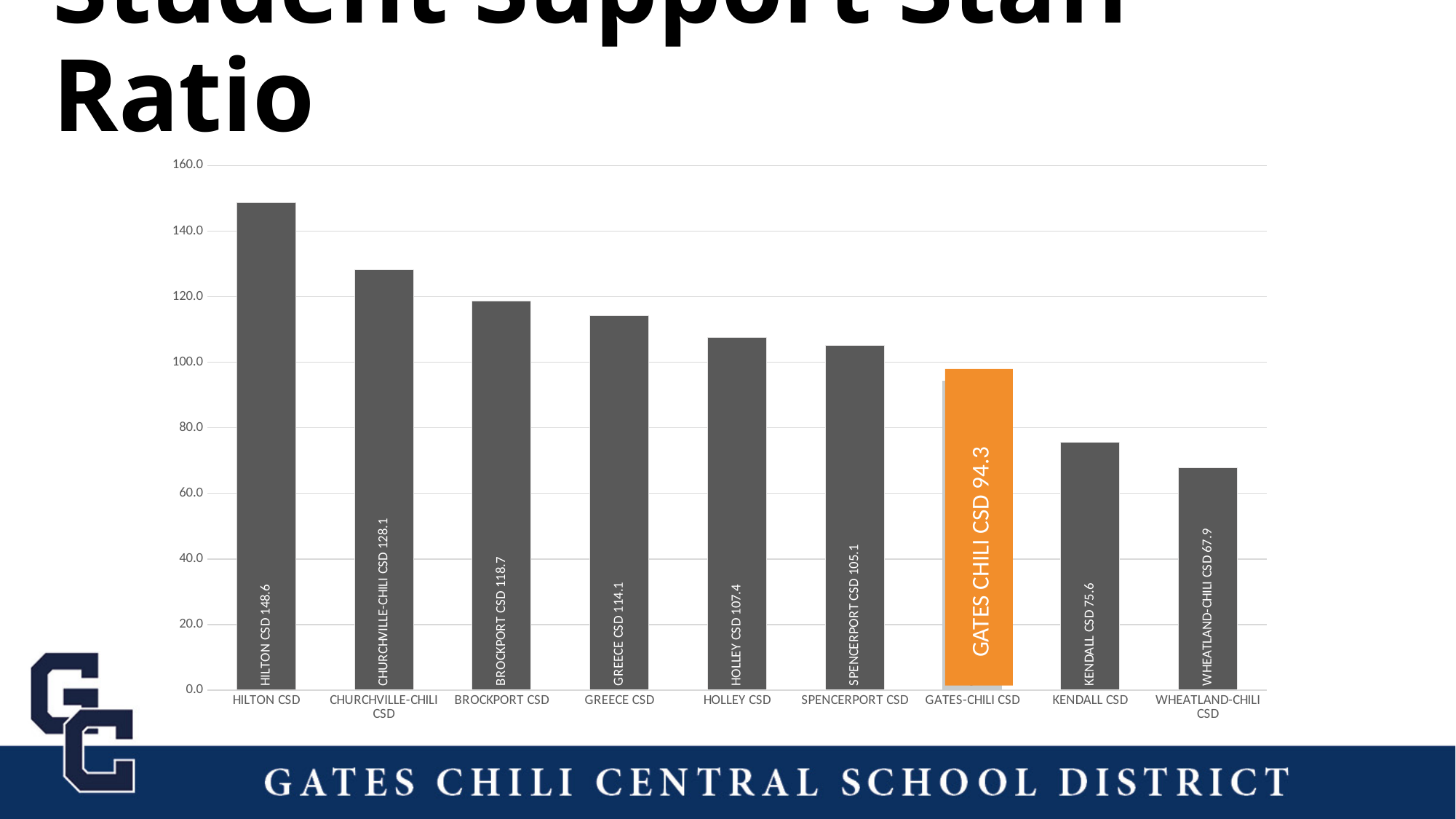
What is the difference between the values for Hilton CSD and Churchville-Chili CSD? 20.5 Which district has the lowest value? Wheatland-Chili CSD What is the value for Gates-Chili CSD? 94.3 What kind of chart is shown on the slide? Bar chart What is the value for Hilton CSD? 148.6 Which district has the highest value? Hilton CSD What is the value for Spencerport CSD? 105.1 What is the value for Wheatland-Chili CSD? 67.9 How many districts are shown on the chart? 9 Which district's bar is highlighted in orange? Gates-Chili CSD What is the difference between the values for Kendall CSD and Wheatland-Chili CSD? 7.7 Which is larger, the value for Brockport CSD or the value for Greece CSD? Brockport CSD